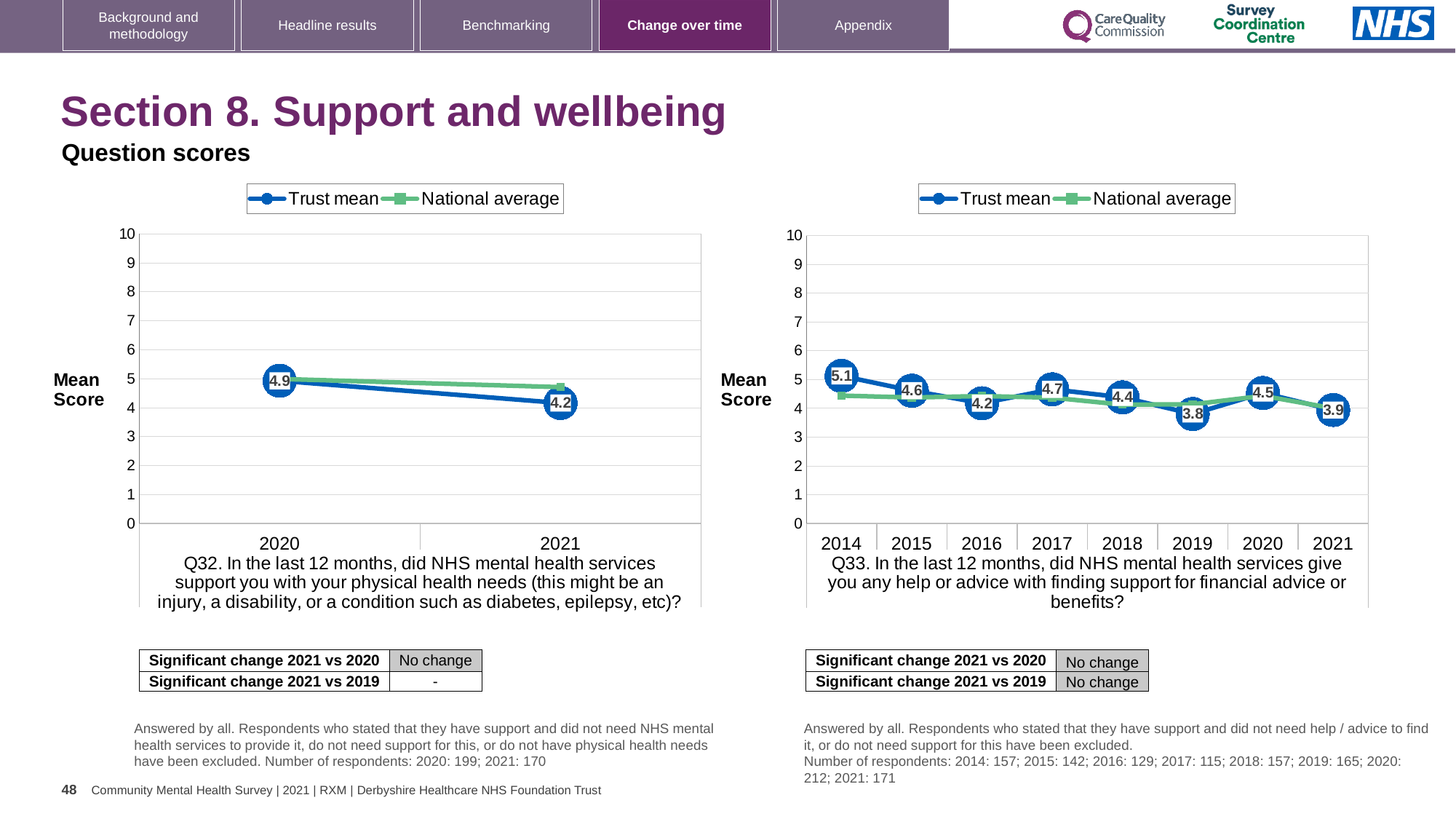
In the Q33 chart on the right, what is the Trust mean score for 2019? 3.8 How many series does the legend of the Q32 chart on the left list? 2 In the Q33 chart on the right, what is the Trust mean score for 2014? 5.1 In the Q32 chart on the left, what is the Trust mean score for 2021? 4.2 In the Q33 chart on the right, is the Trust mean higher in 2020 or in 2021? 2020 In the Q32 chart on the left, by how much did the Trust mean fall from 2020 to 2021? 0.7 In the Q32 chart on the left, what is the Trust mean score for 2020? 4.9 In the Q33 chart on the right, how many years are shown on the x axis? 8 In the Q33 chart on the right, which year has the lowest Trust mean score? 2019 What type of chart is the Q33 chart on the right? Line chart In the Q33 chart on the right, what is the difference between the Trust mean in 2017 and in 2018? 0.3 In the Q33 chart on the right, which year has the highest Trust mean score? 2014